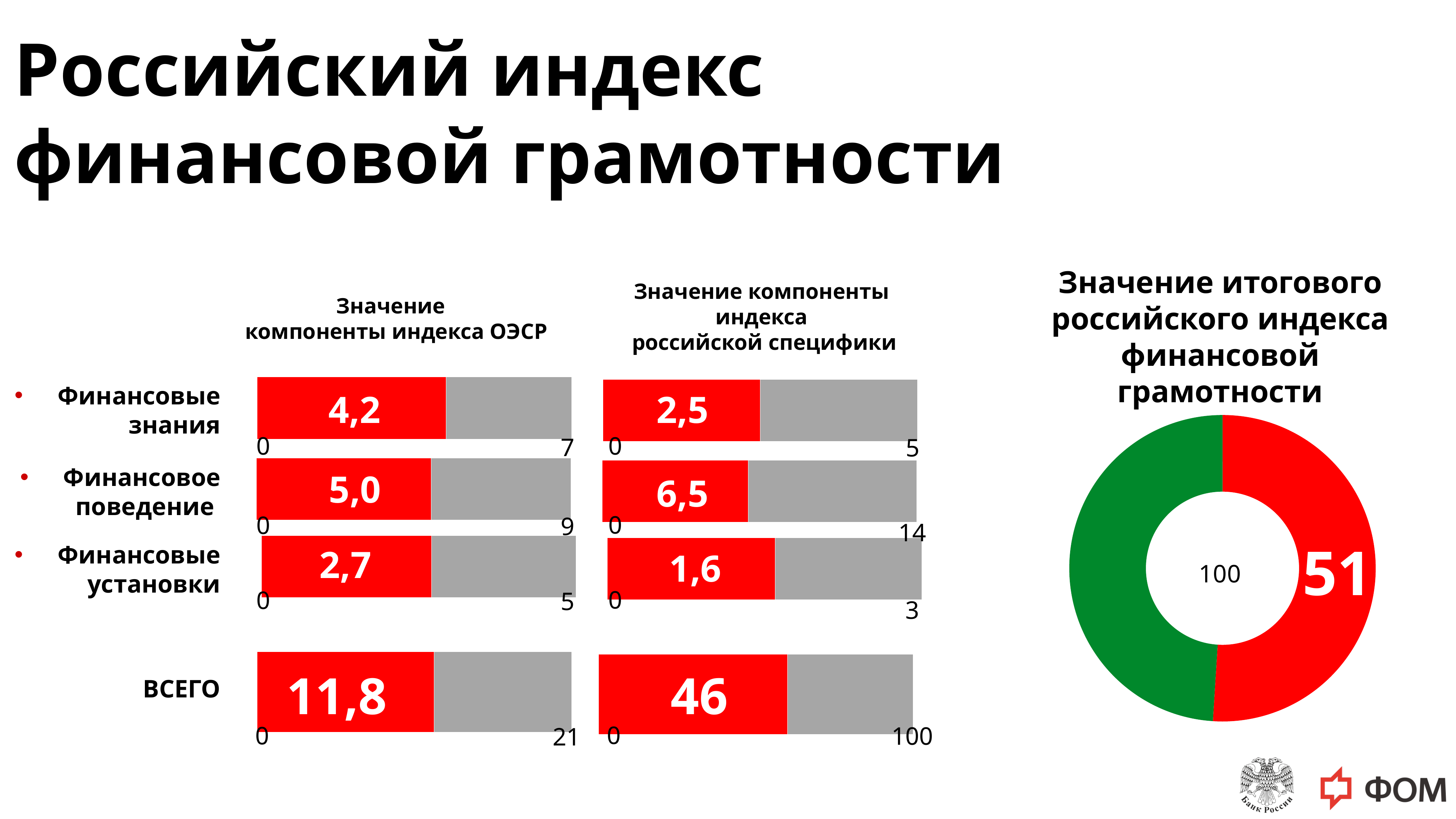
In the chart 'Значение компоненты индекса ОЭСР', what is the value for Финансовые знания? 4,2 In the chart 'Значение компоненты индекса ОЭСР', what is the maximum scale value shown for the ВСЕГО bar? 21 In the chart 'Значение компоненты индекса ОЭСР', which of the three components has the highest value? Финансовое поведение In the donut chart 'Значение итогового российского индекса финансовой грамотности', what value is shown for the red segment? 51 For Финансовые знания, which chart shows the larger value: 'Значение компоненты индекса ОЭСР' or 'Значение компоненты индекса российской специфики'? Значение компоненты индекса ОЭСР In the chart 'Значение компоненты индекса ОЭСР', what is the difference between Финансовое поведение and Финансовые установки? 2,3 In the chart 'Значение компоненты индекса российской специфики', what is the value for ВСЕГО? 46 In the chart 'Значение компоненты индекса российской специфики', what is the value for Финансовое поведение? 6,5 In the chart 'Значение компоненты индекса российской специфики', which of the three components has the lowest value? Финансовые установки In the chart 'Значение компоненты индекса ОЭСР', what is the value for ВСЕГО? 11,8 In the chart 'Значение компоненты индекса ОЭСР', what is the value for Финансовое поведение? 5,0 In the chart 'Значение компоненты индекса российской специфики', what is the value for Финансовые установки? 1,6